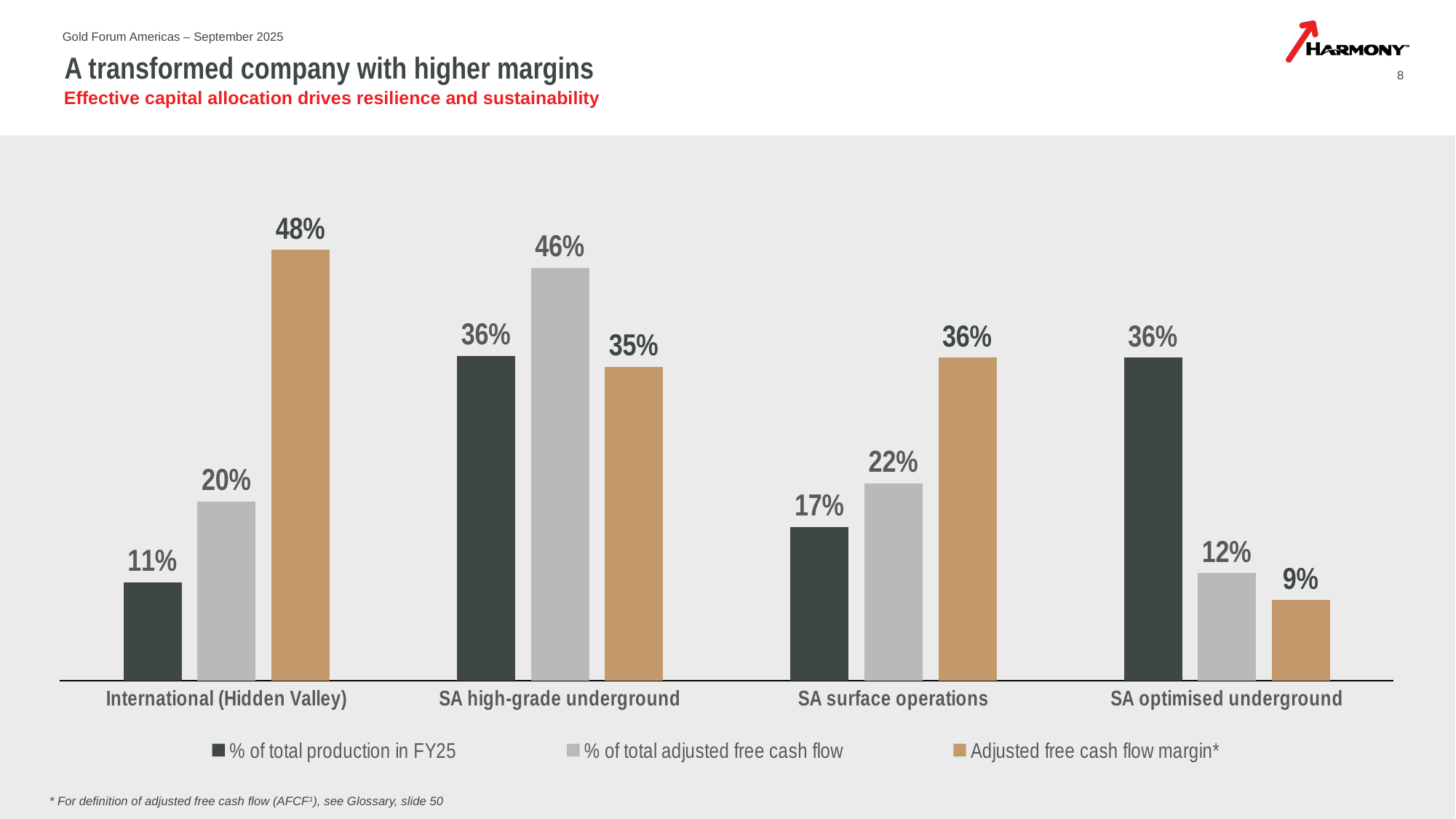
Which category has the lowest % of total adjusted free cash flow? SA optimised underground What is the adjusted free cash flow margin for SA optimised underground? 9% What is the % of total production in FY25 for International (Hidden Valley)? 11% How many series does the legend list? 3 How many categories are shown on the x axis? 4 What is the difference between the % of total adjusted free cash flow and the % of total production in FY25 for SA optimised underground? 24% Which colour represents the adjusted free cash flow margin series in the legend? Tan/brown What is the difference between the adjusted free cash flow margin for International (Hidden Valley) and for SA high-grade underground? 13% Which category has the highest adjusted free cash flow margin? International (Hidden Valley) What kind of chart is shown on the slide? Bar chart Which is larger for SA surface operations: the % of total production in FY25 or the adjusted free cash flow margin? Adjusted free cash flow margin What is the % of total adjusted free cash flow for SA high-grade underground? 46%